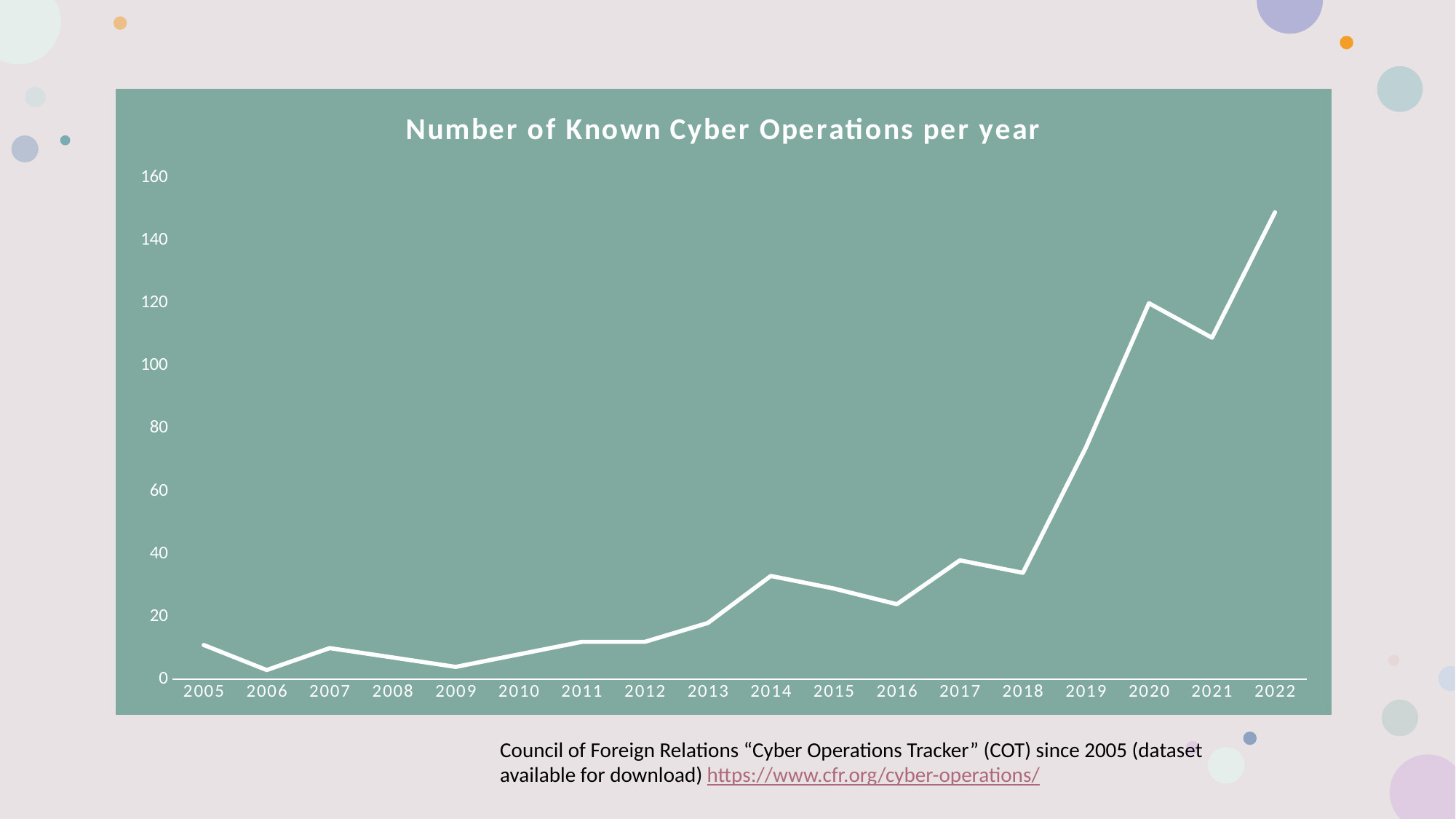
How many years are plotted along the x axis? 18 Which year has the larger value, 2014 or 2016? 2014 What is the title of the chart? Number of Known Cyber Operations per year Which year has the highest number of known cyber operations? 2022 Is the value for 2006 greater or less than 20? less Is the value for 2022 greater or less than 140? greater What kind of chart is shown on the slide? Line chart Is the value for 2019 greater or less than 60? greater Overall, do the values rise or fall from 2005 to 2022? rise Which year has the larger value, 2020 or 2021? 2020